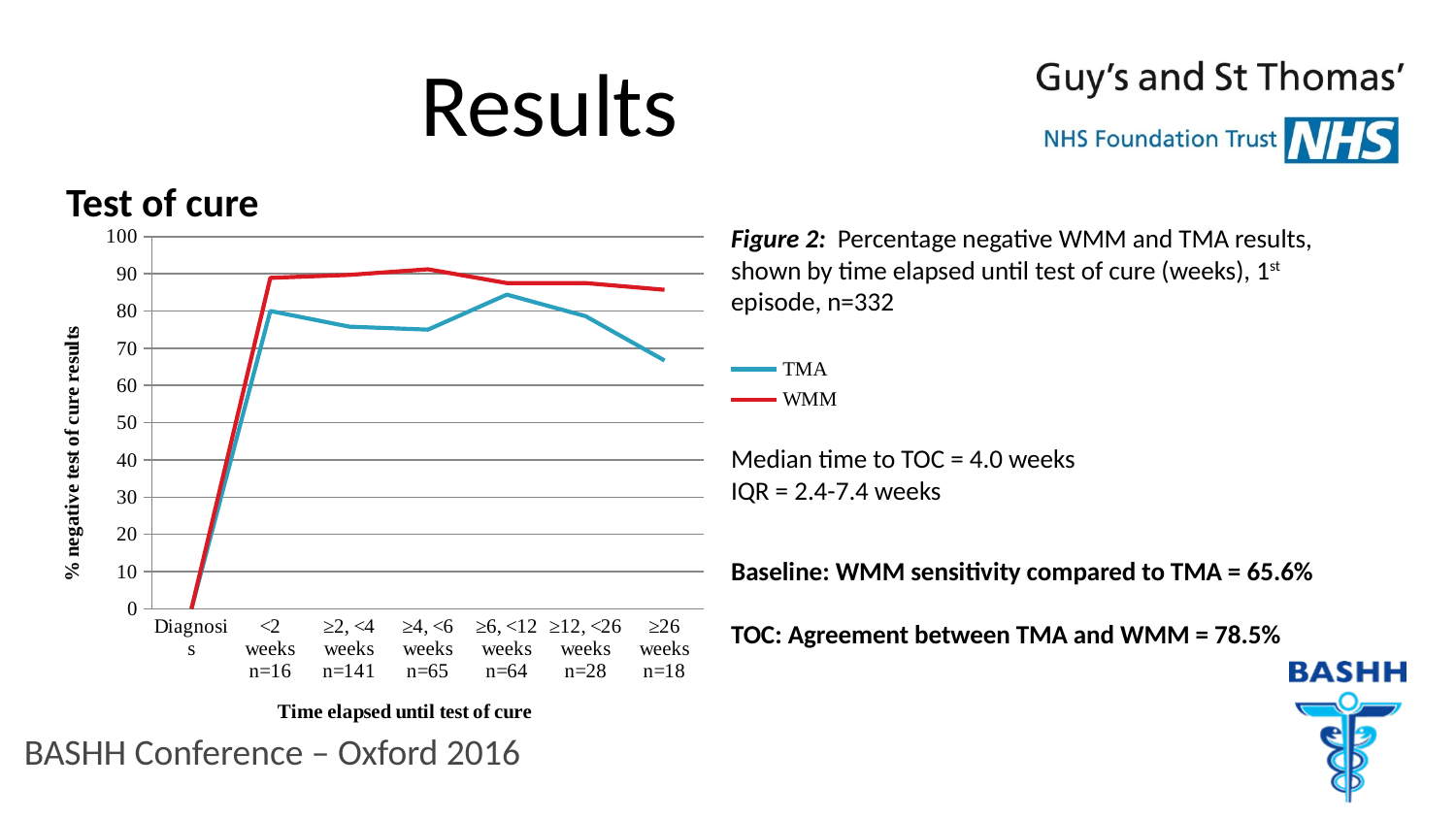
Is the WMM value for ≥4, <6 weeks greater or less than 80? greater At ≥4, <6 weeks, which series has the higher value, TMA or WMM? WMM Which category has the lowest TMA value? Diagnosis How many series does the chart's legend list? 2 Is the TMA value for ≥2, <4 weeks greater or less than 70? greater What kind of chart is shown on the slide? line chart What is the title of the chart's y axis? % negative test of cure results Does the TMA line rise or fall from ≥6, <12 weeks to ≥26 weeks? fall At ≥26 weeks, which series has the higher value, TMA or WMM? WMM How many categories are shown along the x axis of the chart? 7 What is the value for both TMA and WMM at the Diagnosis category? 0 Is the TMA value for ≥26 weeks greater or less than 70? less